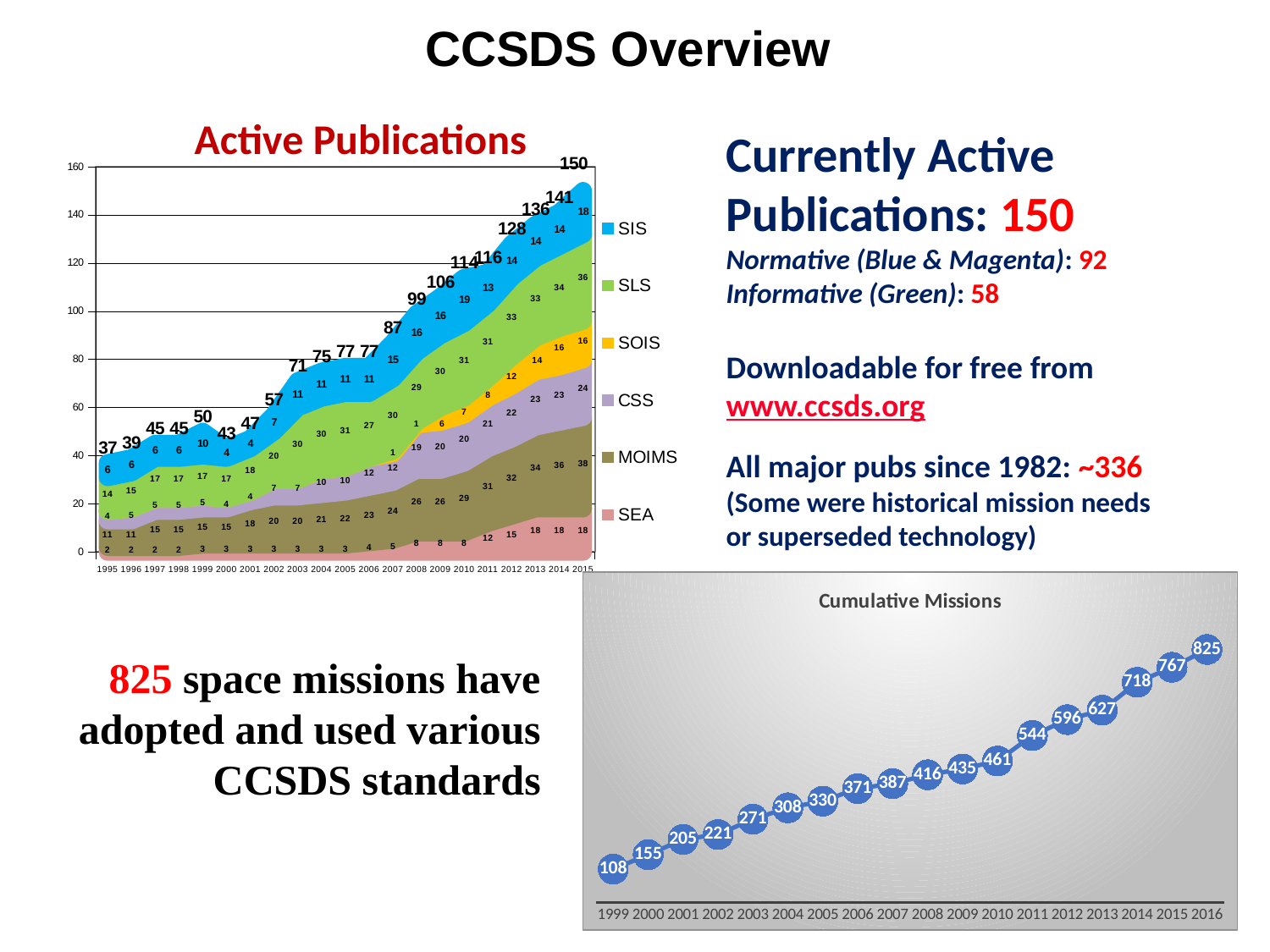
How many series does the legend of the Active Publications chart list? 6 In the Cumulative Missions chart, by how much did the value increase from 1999 to 2016? 717 In the Cumulative Missions chart, do the values rise or fall from 1999 to 2016? rise In the Active Publications chart, what is the total number of active publications in 1995? 37 In the Active Publications chart, which year has the highest total? 2015 In the Cumulative Missions chart, what is the value for 1999? 108 In the Cumulative Missions chart, what is the value for 2011? 544 How many data points are plotted in the Cumulative Missions chart? 18 In the Cumulative Missions chart, what is the value for 2016? 825 What kind of chart is the Cumulative Missions chart? line chart In the Active Publications chart, what is the SEA value in 2015? 18 In the Active Publications chart, what is the total number of active publications in 2015? 150